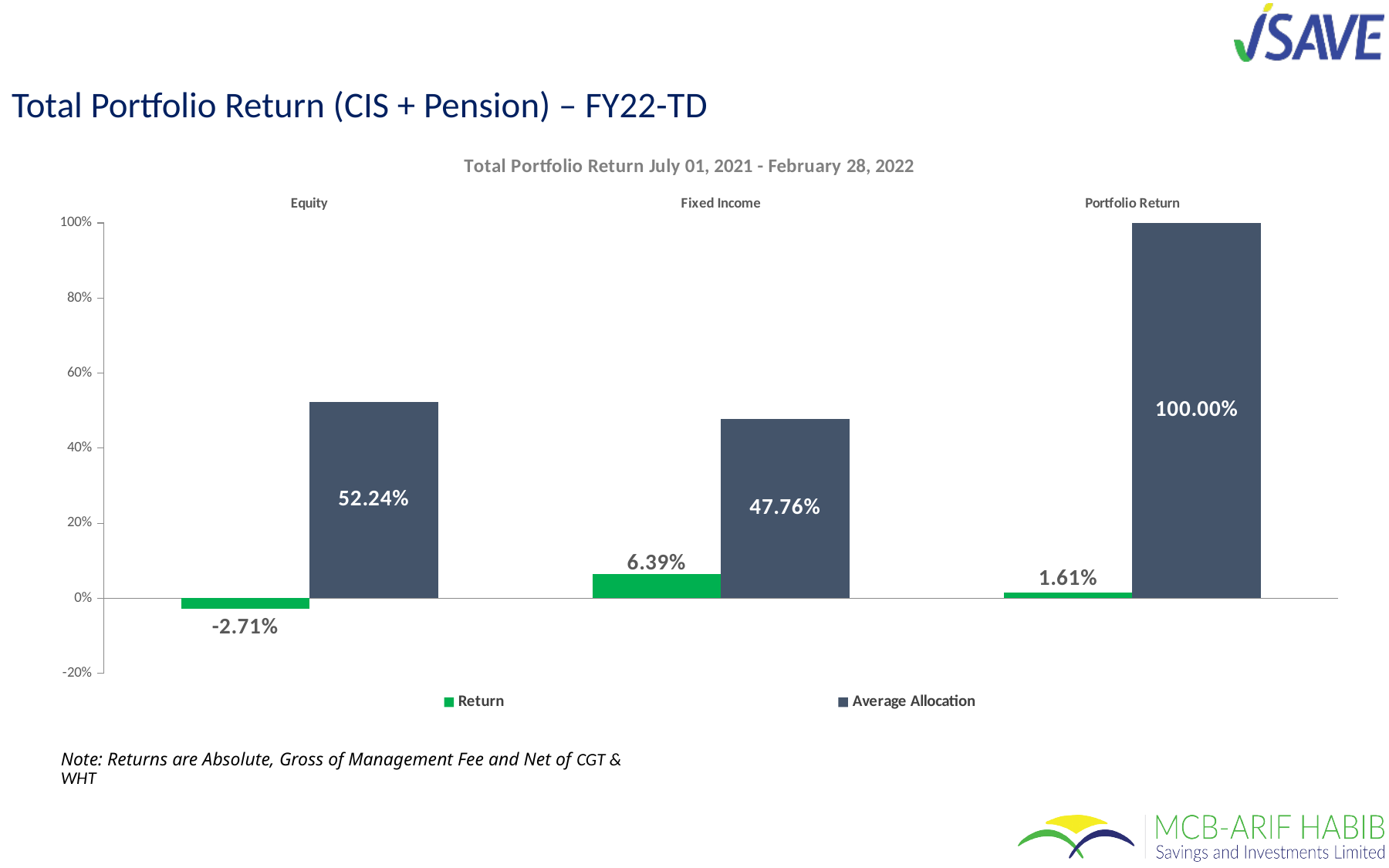
How many categories are shown on the x axis? 3 What is the Return value for Portfolio Return? 1.61% What is the difference between the Average Allocation for Equity and for Fixed Income? 4.48% Which is larger, the Return for Fixed Income or the Return for Portfolio Return? Fixed Income What is the Average Allocation for Equity? 52.24% How many series does the legend list? 2 What is the title of the chart? Total Portfolio Return July 01, 2021 - February 28, 2022 Which category has the lowest Return? Equity What is the Return value for Equity? -2.71% What kind of chart is shown on the slide? Bar chart Which category has the highest Return? Fixed Income What is the Average Allocation for Fixed Income? 47.76%